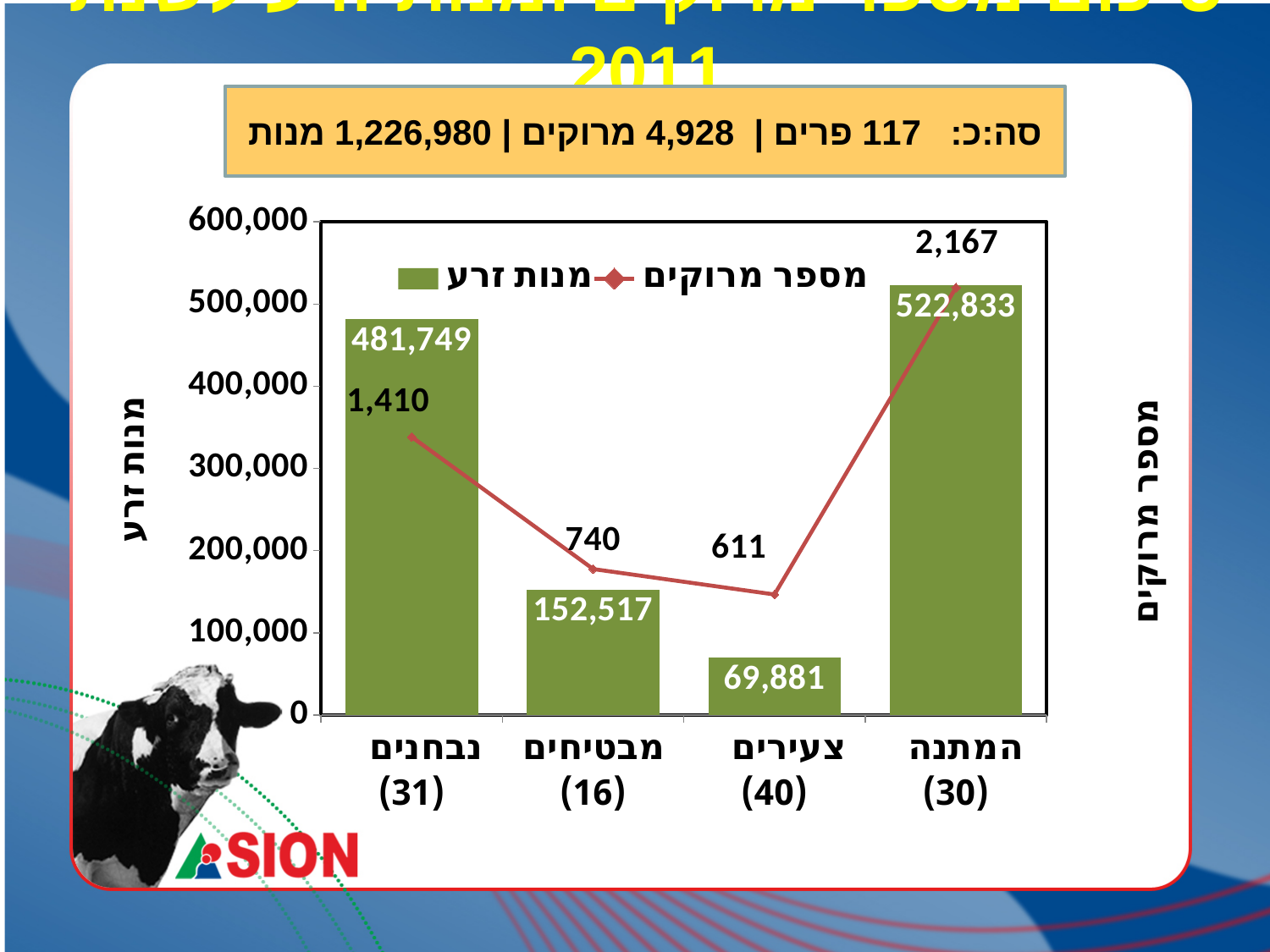
What is the value of מנות זרע for the category נבחנים (31)? 481,749 Which category has the highest value of מנות זרע? המתנה (30) What kind of chart is shown on the slide? Combined bar and line chart What is the value of מספר מרוקים for the category מבטיחים (16)? 740 Which has a larger value of מספר מרוקים: נבחנים (31) or מבטיחים (16)? נבחנים (31) What is the value of מספר מרוקים for the category צעירים (40)? 611 Which category has the lowest value of מספר מרוקים? צעירים (40) Which series is drawn as a line in the chart? מספר מרוקים How many series does the chart's legend list? 2 What is the difference in מנות זרע between המתנה (30) and נבחנים (31)? 41,084 What is the value of מנות זרע for the category המתנה (30)? 522,833 How many categories are shown on the x axis of the chart? 4